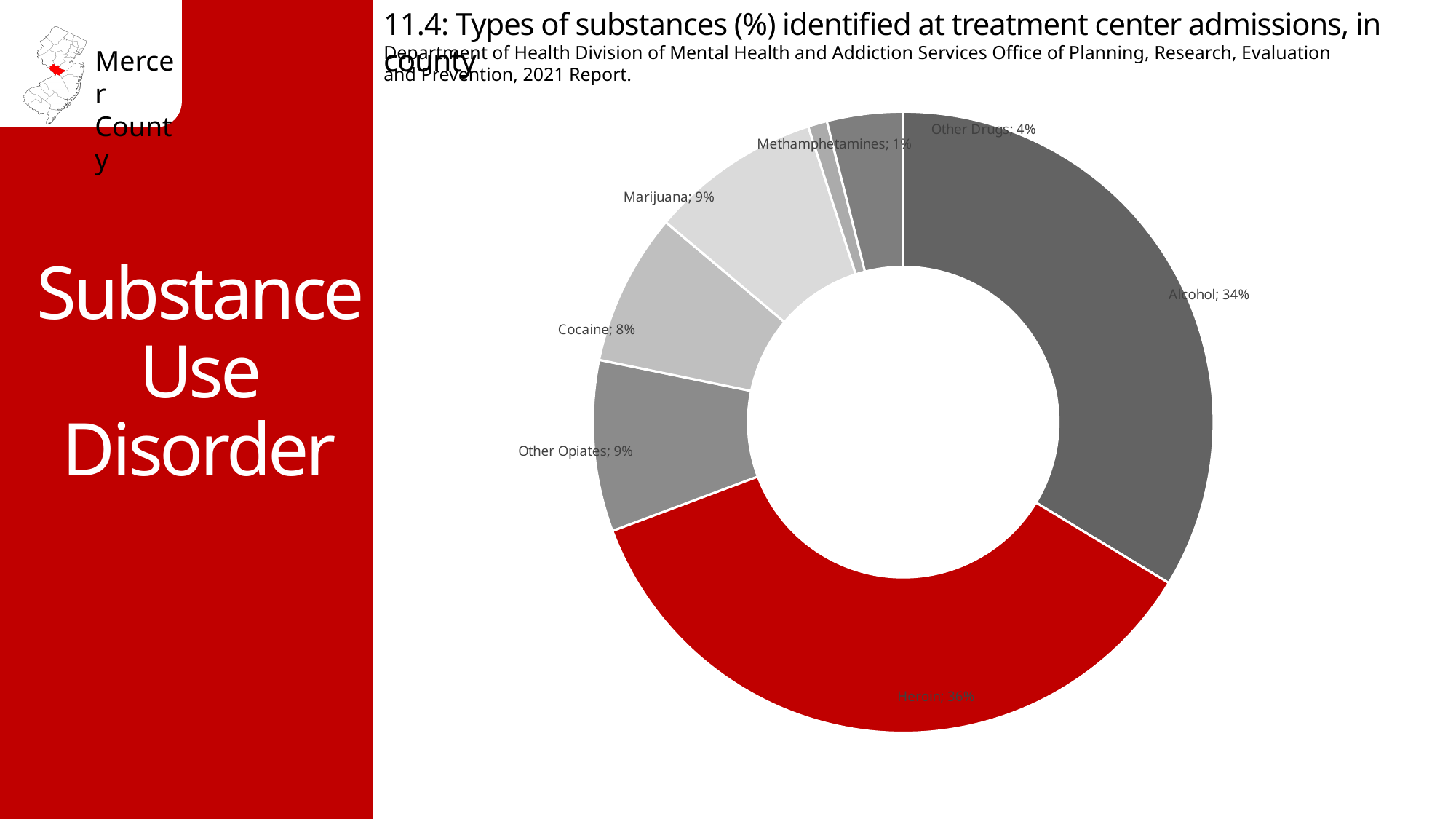
What percentage of treatment center admissions is attributed to Alcohol? 34% Which substance has the smallest share of admissions? Methamphetamines What percentage is shown for Cocaine? 8% What percentage is shown for Methamphetamines? 1% What percentage is shown for Other Drugs? 4% What percentage is shown for Other Opiates? 9% How many substance categories are shown in the chart? 7 What kind of chart is used on this slide? Doughnut (pie) chart What percentage is shown for Marijuana? 9% Which is larger, the share for Alcohol or the share for Cocaine? Alcohol Which substance category is shown in red on the chart? Heroin What is the difference in percentage points between Alcohol and Marijuana? 25